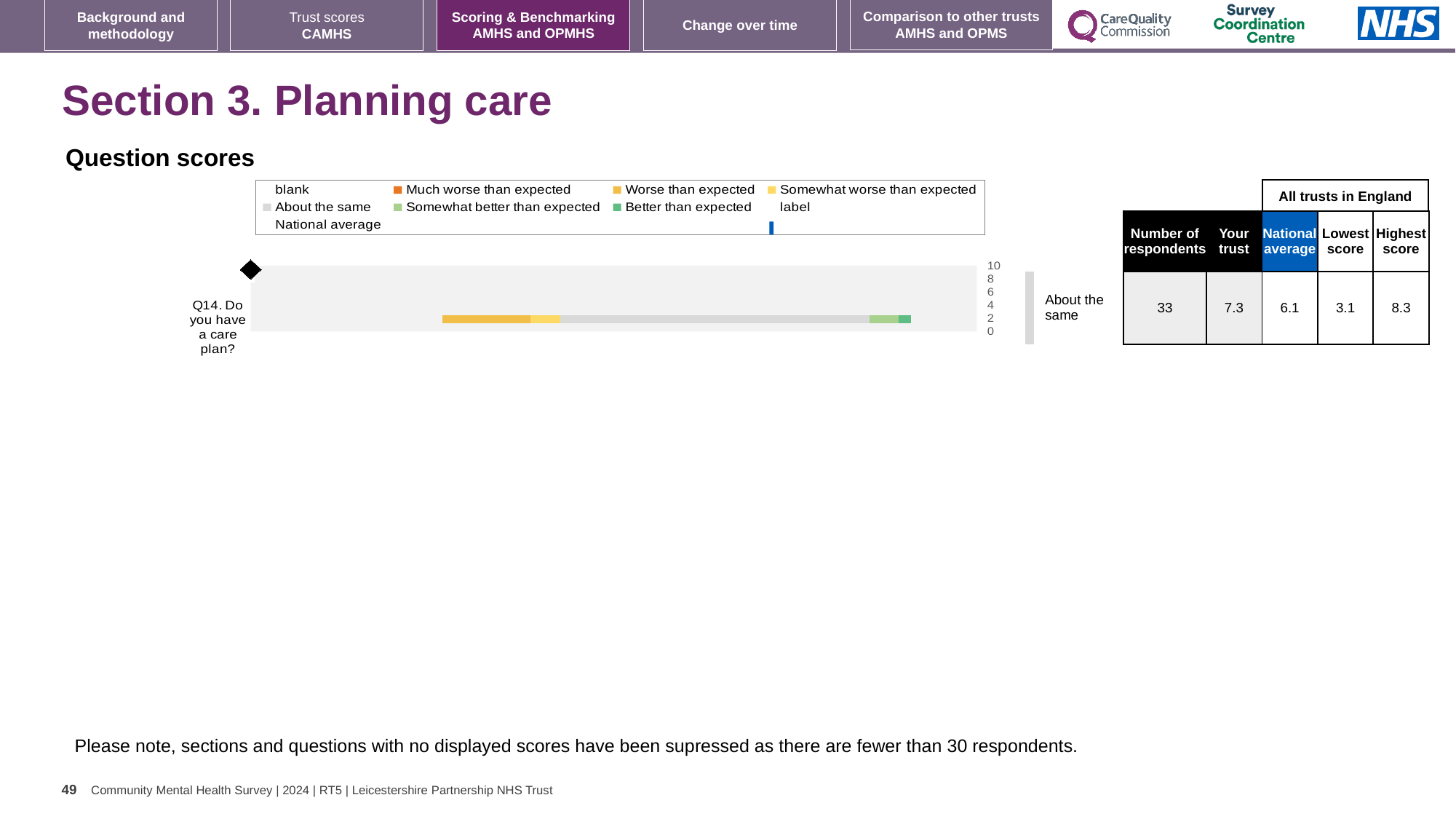
How many respondents answered Q14 (Do you have a care plan?)? 33 What is the lowest score among all trusts in England for Q14? 3.1 How many questions are plotted in the Question scores chart? 1 What is the maximum value shown on the score axis of the chart? 10 What is the national average score for Q14 (Do you have a care plan?)? 6.1 What is the 'Your trust' score for Q14 (Do you have a care plan?)? 7.3 What is the highest score among all trusts in England for Q14? 8.3 By how much does the 'Your trust' score for Q14 exceed the national average? 1.2 What kind of chart is used to show the question scores? Bar chart For Q14, which is larger: the 'Your trust' score or the national average? Your trust What benchmark category is shown for Q14 (Do you have a care plan?)? About the same What is the difference between the highest and lowest scores for Q14 across all trusts in England? 5.2